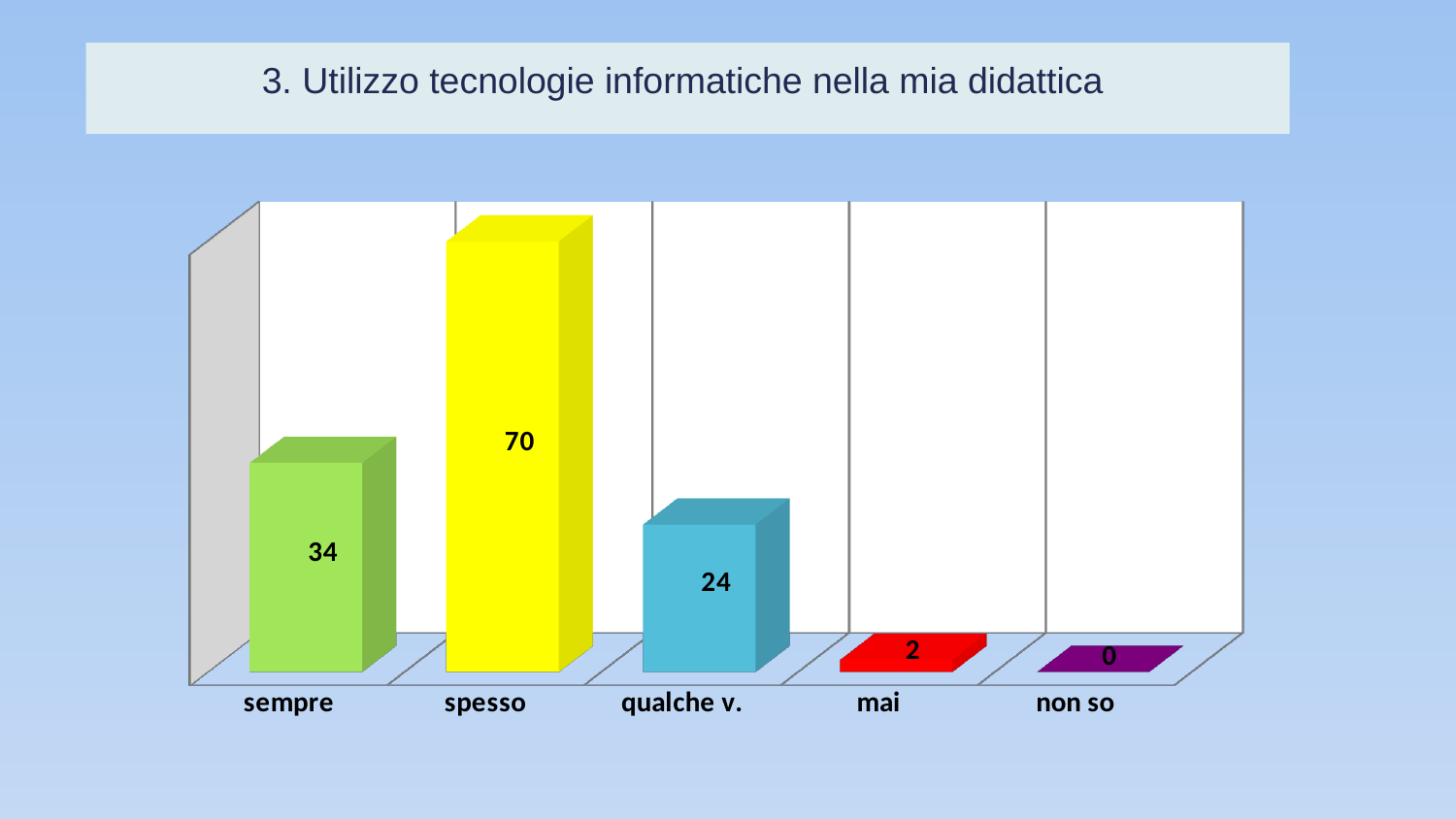
What is the difference between the values for "spesso" and "sempre"? 36 What is the value for "qualche v."? 24 Which category has the highest value? spesso What is the value for "mai"? 2 What is the value for "spesso"? 70 How many categories are shown on the x axis? 5 What is the value for "non so"? 0 What is the title of the chart? 3. Utilizzo tecnologie informatiche nella mia didattica What is the value for "sempre"? 34 Which is larger, the value for "sempre" or the value for "qualche v."? sempre What kind of chart is shown on the slide? bar chart Which category has the lowest value? non so